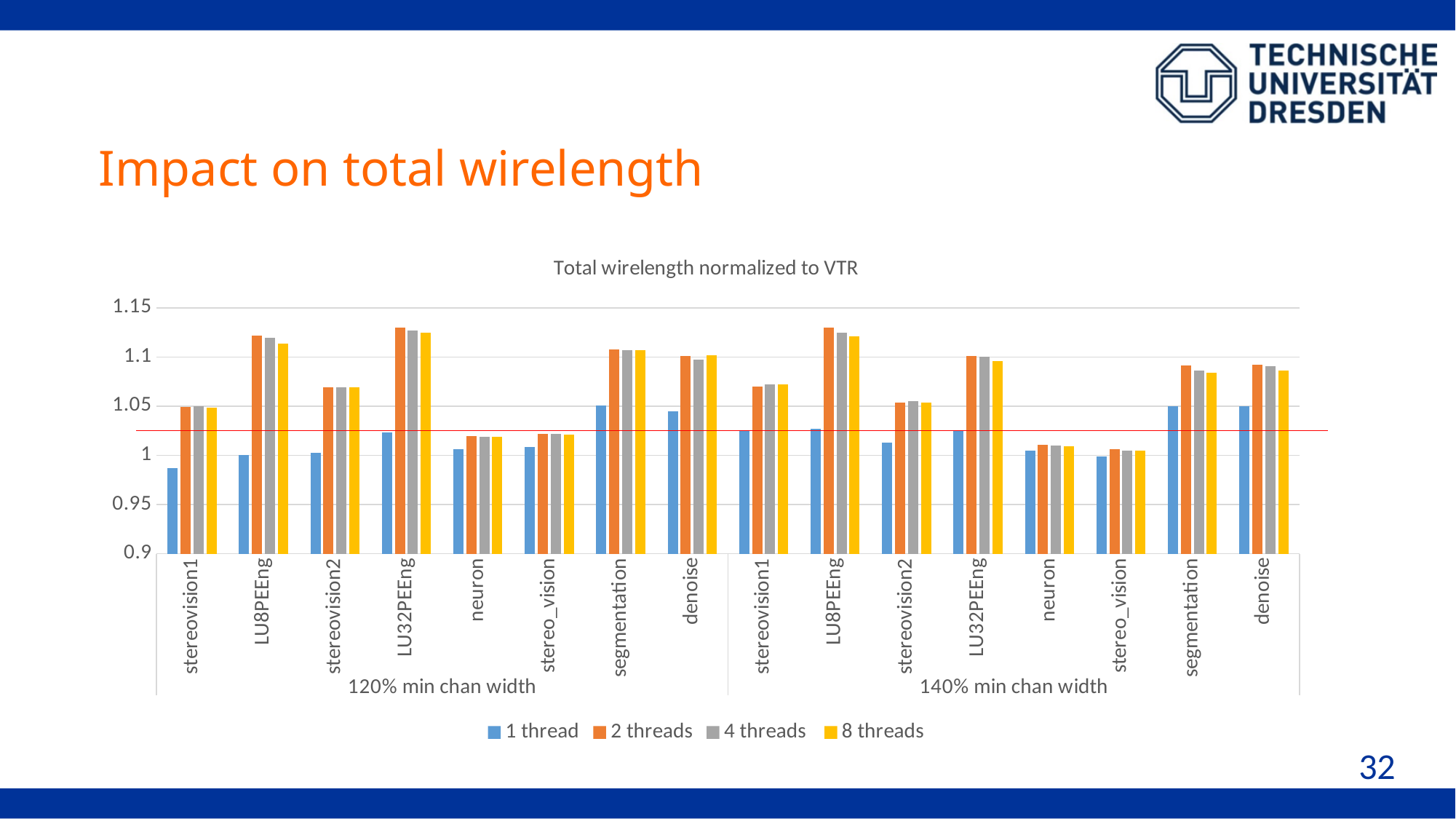
Is the 2 threads value for LU8PEEng in the 120% min chan width group greater or less than 1.1? greater How many benchmark categories are shown under the '120% min chan width' group? 8 Is the 2 threads value for stereovision2 in the 120% min chan width group greater or less than 1.05? greater Is the 2 threads value for neuron in the 120% min chan width group greater or less than 1.05? less How many channel-width groups are shown along the x axis? 2 What kind of chart is shown on the slide? bar chart What is the title of the chart? Total wirelength normalized to VTR In the 120% min chan width group, which is larger for LU8PEEng: the 1 thread value or the 2 threads value? 2 threads In the 120% min chan width group, which is larger for 2 threads: neuron or segmentation? segmentation How many series does the legend list? 4 Which series is shown in blue in the legend? 1 thread